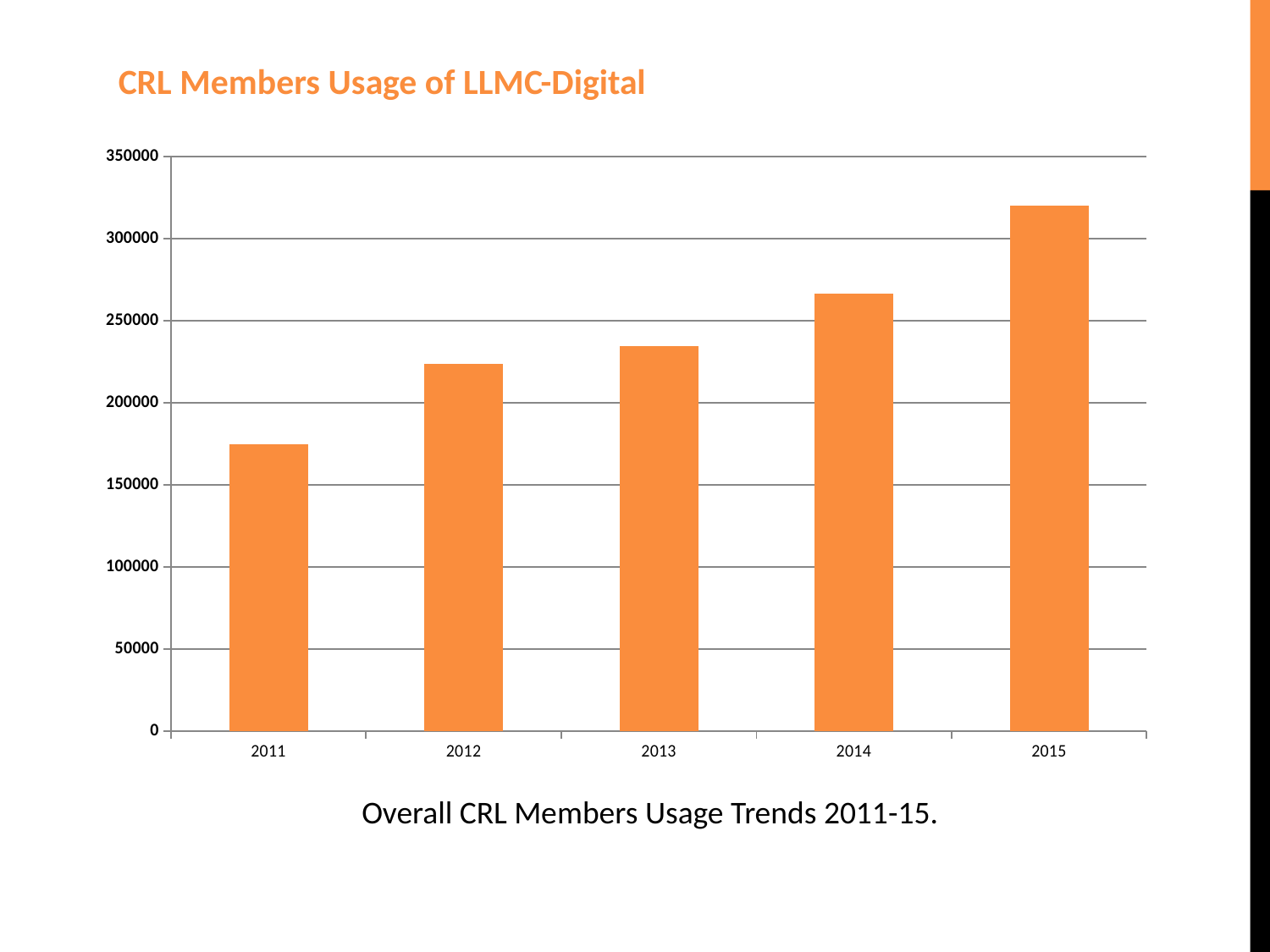
Which year has the lowest usage? 2011 What is the title of the chart? CRL Members Usage of LLMC-Digital Is the value for 2013 greater or less than 250000? less What kind of chart is shown on the slide? bar chart Is the value for 2015 greater or less than 300000? greater Is the value for 2014 greater or less than 250000? greater Do the values rise or fall from 2011 to 2015? rise Which is larger, the value for 2013 or the value for 2014? 2014 How many years are plotted on the x axis? 5 Which year has the highest usage? 2015